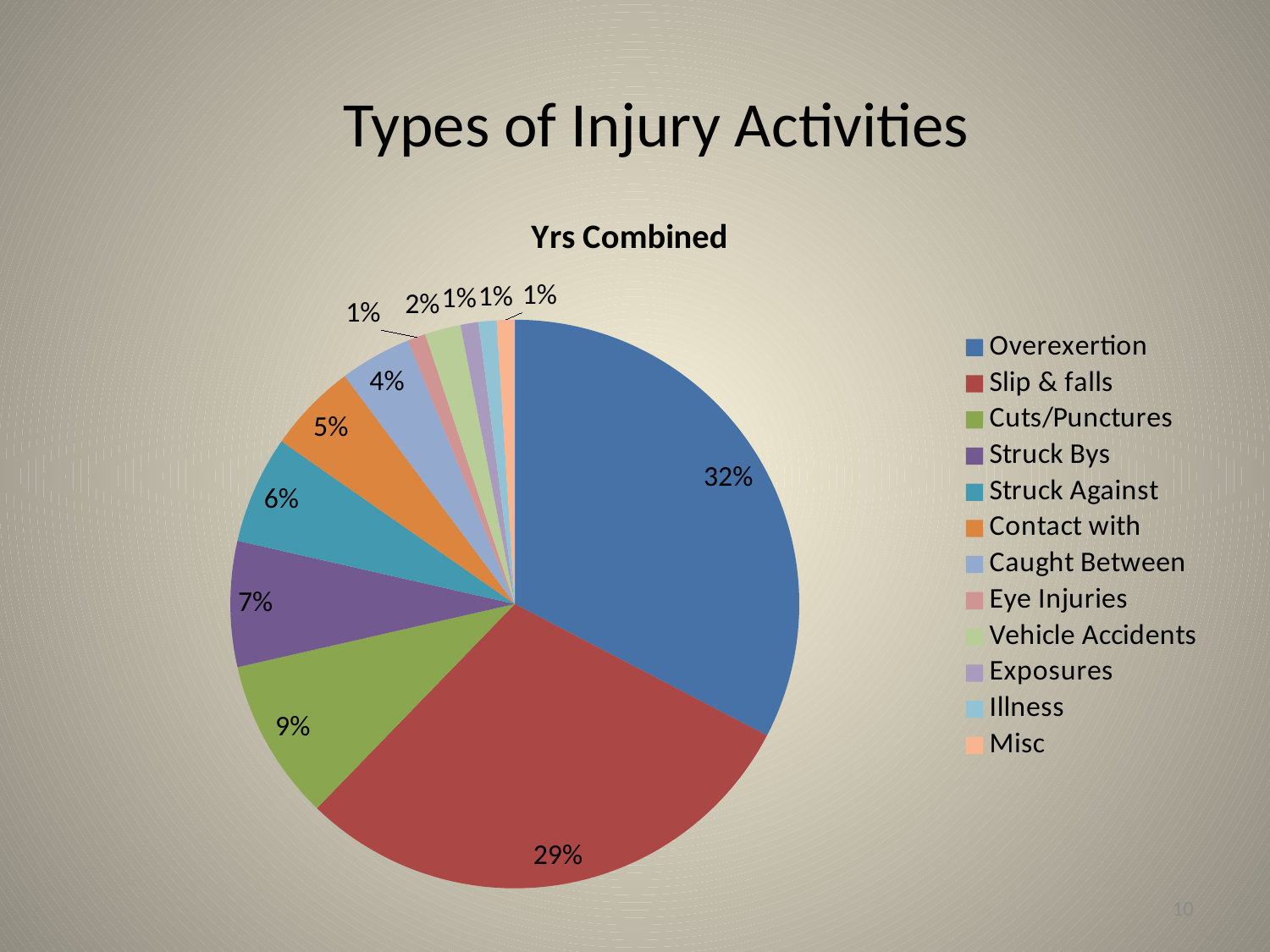
What is the difference in percentage points between Overexertion and Slip & falls? 3% What is the title of the chart? Yrs Combined What share of the pie does Overexertion represent? 32% What percentage is shown for Cuts/Punctures? 9% Which category has the largest share of the pie? Overexertion How many categories does the legend list? 12 What percentage is shown for Struck Against? 6% What percentage is shown for Struck Bys? 7% Which is larger, the share for Cuts/Punctures or the share for Struck Bys? Cuts/Punctures What percentage is shown for Contact with? 5% What share of the pie does Slip & falls represent? 29% What type of chart is shown on the slide? pie chart